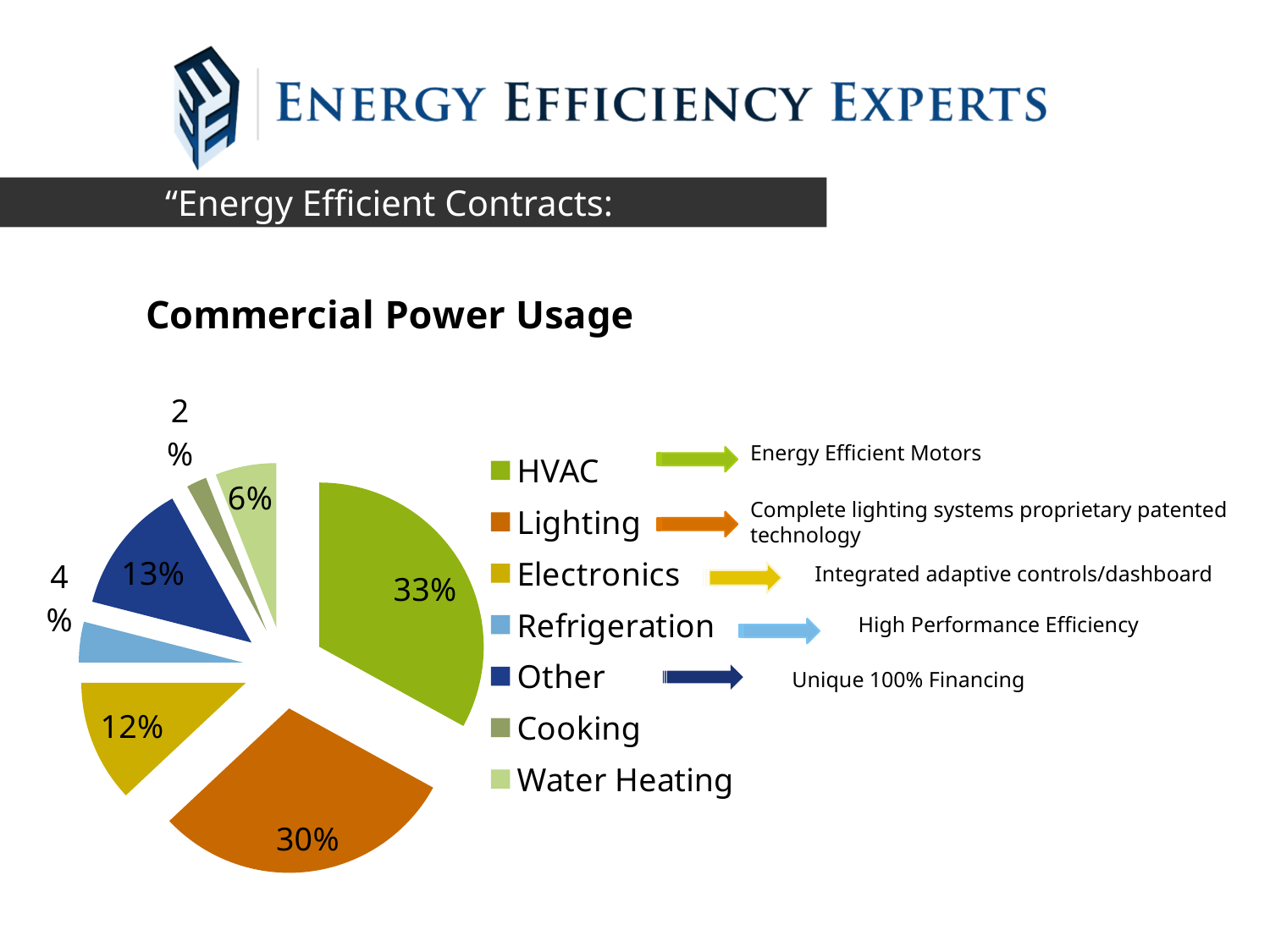
What is the value shown for Refrigeration? 4% Which is larger, the share for Other or the share for Electronics? Other What percentage of commercial power usage is attributed to HVAC? 33% What is the difference in percentage points between HVAC and Lighting? 3 What percentage of commercial power usage is attributed to Lighting? 30% What is the value shown for Water Heating? 6% What share of the pie does Electronics represent? 12% Which category has the smallest slice of the pie? Cooking What type of chart is shown on the slide? pie chart How many categories does the legend list? 7 Which category has the largest slice of the pie? HVAC What is the title of the chart? Commercial Power Usage